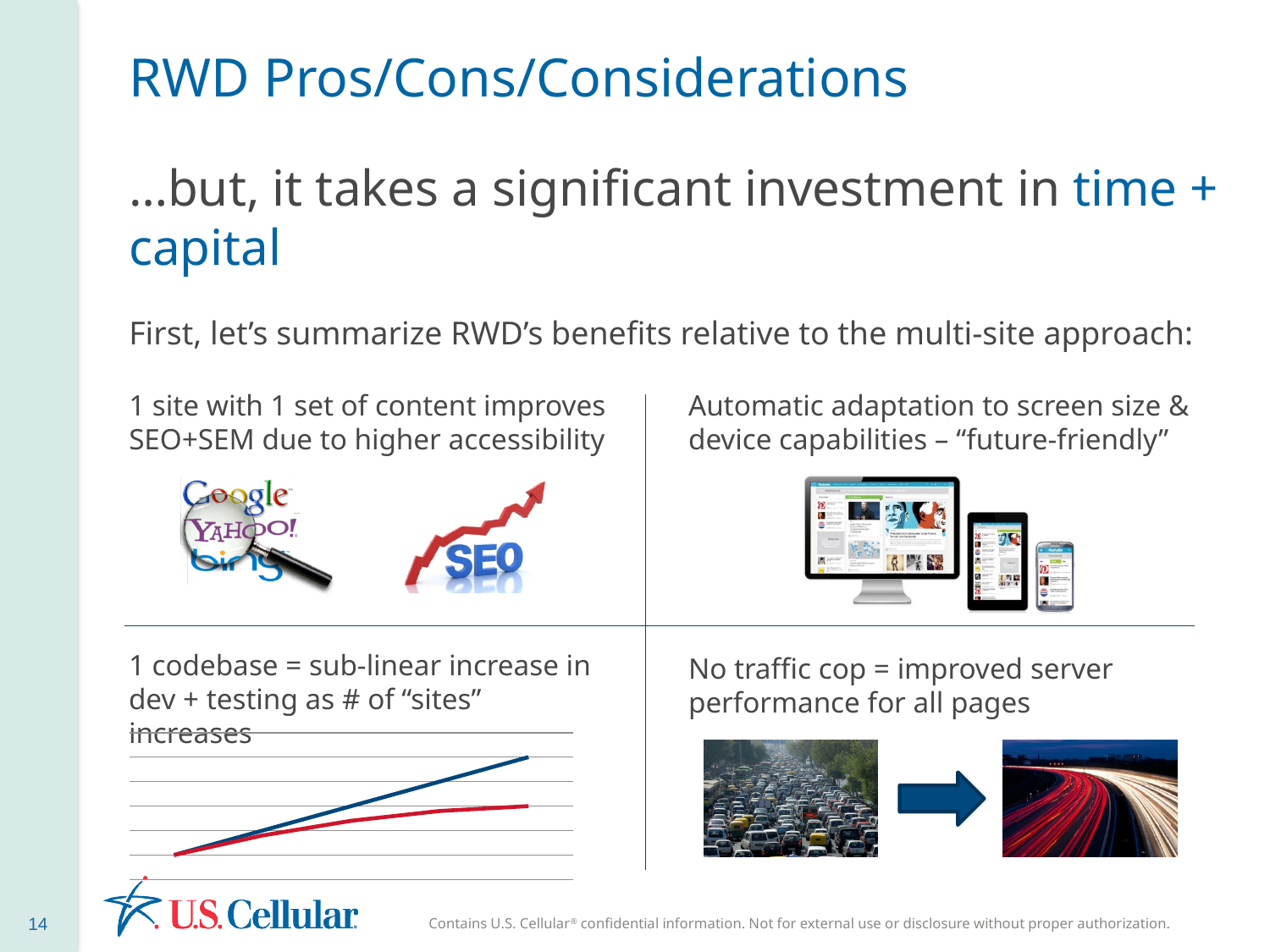
On the chart in the bottom-left of the slide, do the lines rise or fall from left to right? rise Does the chart in the bottom-left of the slide show a legend? No How many lines are plotted on the chart in the bottom-left of the slide? 2 On the chart in the bottom-left of the slide, which line flattens out toward the right, the blue line or the red line? the red line What kind of chart is shown in the bottom-left of the slide? line chart What two colours are the lines on the chart in the bottom-left of the slide? blue and red On the chart in the bottom-left of the slide, which line is higher at the right end, the blue line or the red line? the blue line